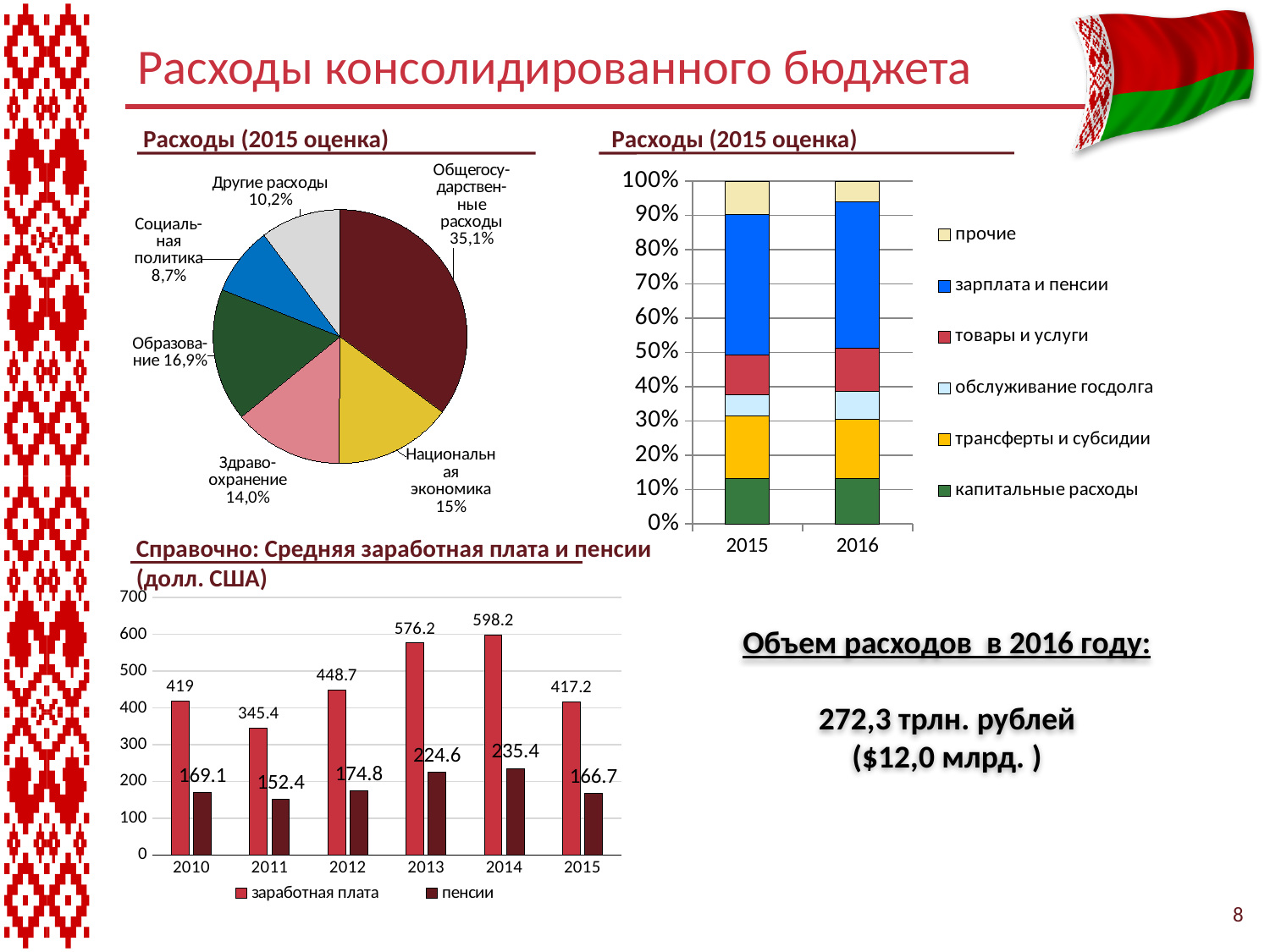
What kind of chart is shown at the top right of the slide? Stacked bar chart In the bar chart at the bottom left of the slide, how many series does the legend list? 2 In the bar chart at the bottom left of the slide, what is the difference between заработная плата and пенсии in 2013? 351.6 In the bar chart at the bottom left of the slide, what is the value for пенсии in 2011? 152.4 In the stacked bar chart at the top right of the slide, how many series does the legend list? 6 In the pie chart at the top left of the slide, which category has the smallest share? Социальная политика In the pie chart at the top left of the slide, which is larger: Образование or Здравоохранение? Образование In the pie chart at the top left of the slide, how many slices are there? 6 In the bar chart at the bottom left of the slide, what is the value for заработная плата in 2014? 598.2 In the stacked bar chart at the top right of the slide, is the top of the капитальные расходы segment for 2015 greater or less than 20%? less In the bar chart at the bottom left of the slide, in which year is заработная плата highest? 2014 In the pie chart at the top left of the slide, what share is labelled for Общегосударственные расходы? 35,1%